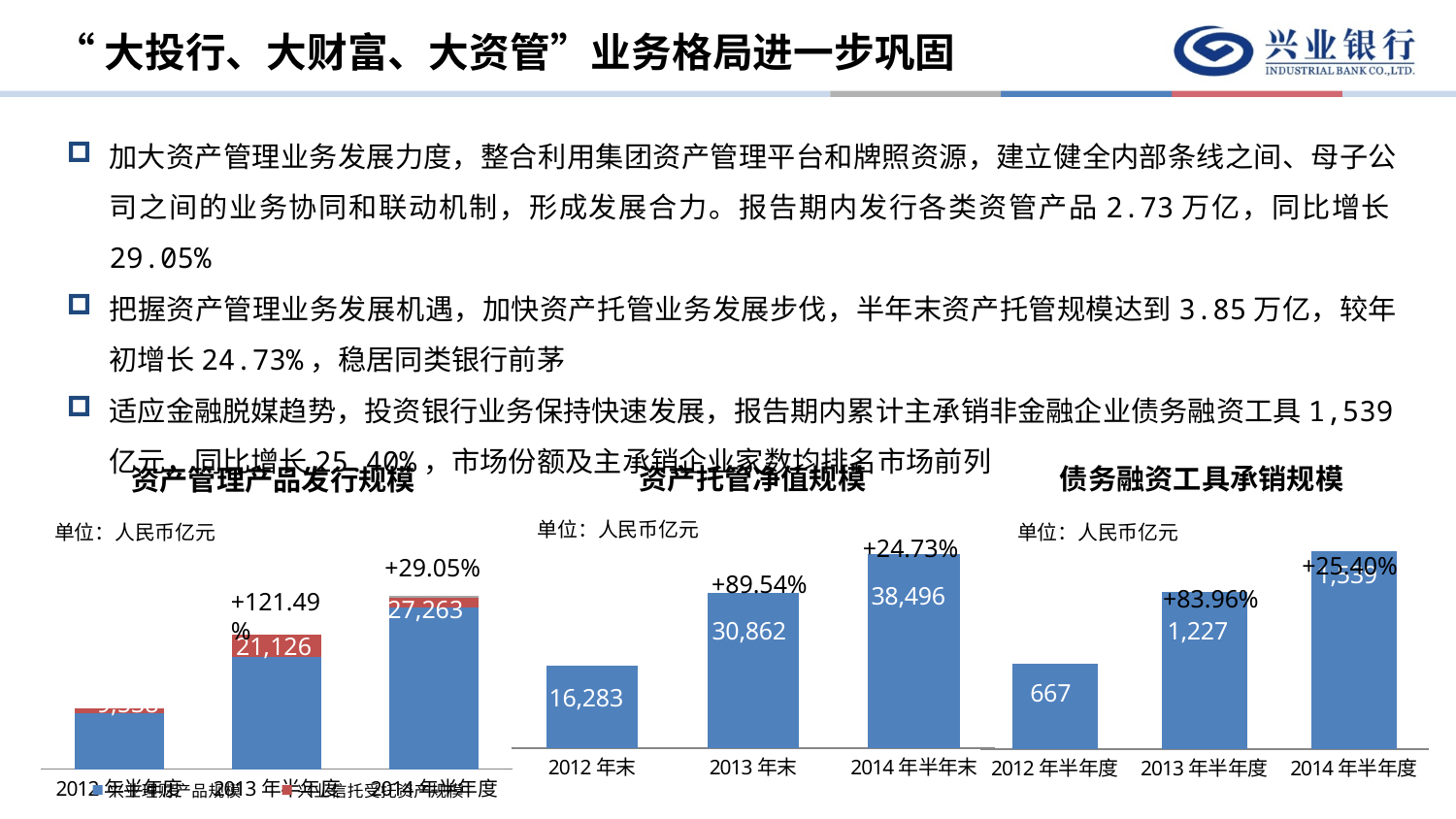
In the 资产托管净值规模 chart, what is the value for 2014年半年末? 38,496 In the 债务融资工具承销规模 chart, which category has the lowest value? 2012年半年度 In the 债务融资工具承销规模 chart, what is the value for 2013年半年度? 1,227 In the 资产管理产品发行规模 chart, what is the total value labelled for 2014年半年度? 27,263 In the 资产托管净值规模 chart, what is the value for 2013年末? 30,862 How many categories are shown on the x axis of the 债务融资工具承销规模 chart? 3 In the 资产托管净值规模 chart, what is the value for 2012年末? 16,283 In the 债务融资工具承销规模 chart, what is the difference between the values for 2013年半年度 and 2012年半年度? 560 In the 资产托管净值规模 chart, do the values rise or fall from 2012年末 to 2014年半年末? rise In the 资产托管净值规模 chart, which category has the highest value? 2014年半年末 In the 资产托管净值规模 chart, what is the difference between the values for 2013年末 and 2012年末? 14,579 In the 债务融资工具承销规模 chart, what is the value for 2012年半年度? 667